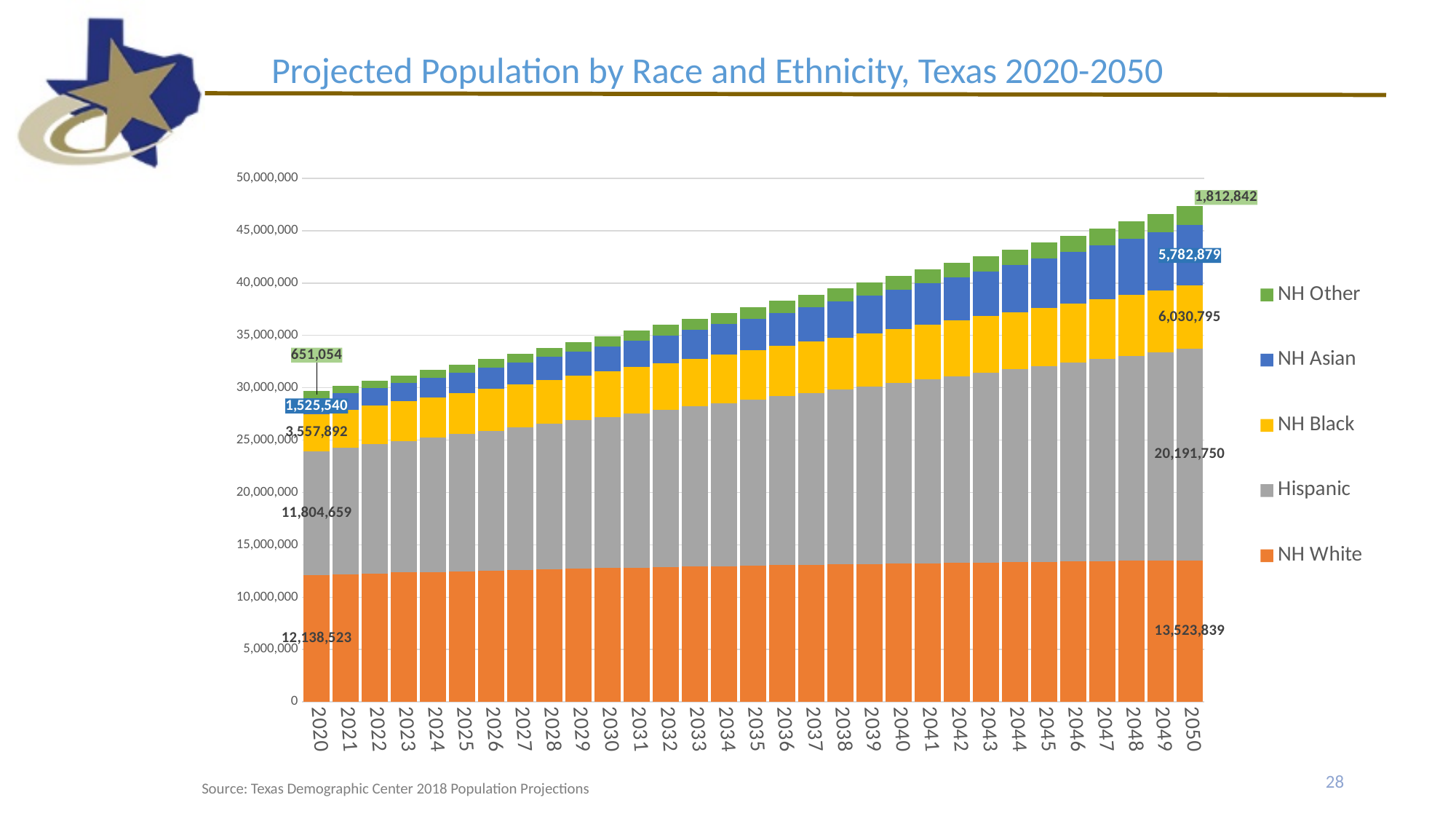
By how much is the projected Hispanic population in 2050 larger than in 2020? 8,387,091 Which group has the largest projected population in 2050? Hispanic How many years are shown along the x axis? 31 What is the projected NH Other population in 2020? 651,054 What is the projected NH Asian population in 2050? 5,782,879 What is the projected NH White population in 2020? 12,138,523 Is the total projected population for 2045 greater or less than 40,000,000? greater How many series does the legend list? 5 What type of chart is shown on the slide? Stacked bar chart What is the total projected population for 2050? 47,342,105 What is the projected Hispanic population in 2050? 20,191,750 Which group has the smallest projected population in 2020? NH Other